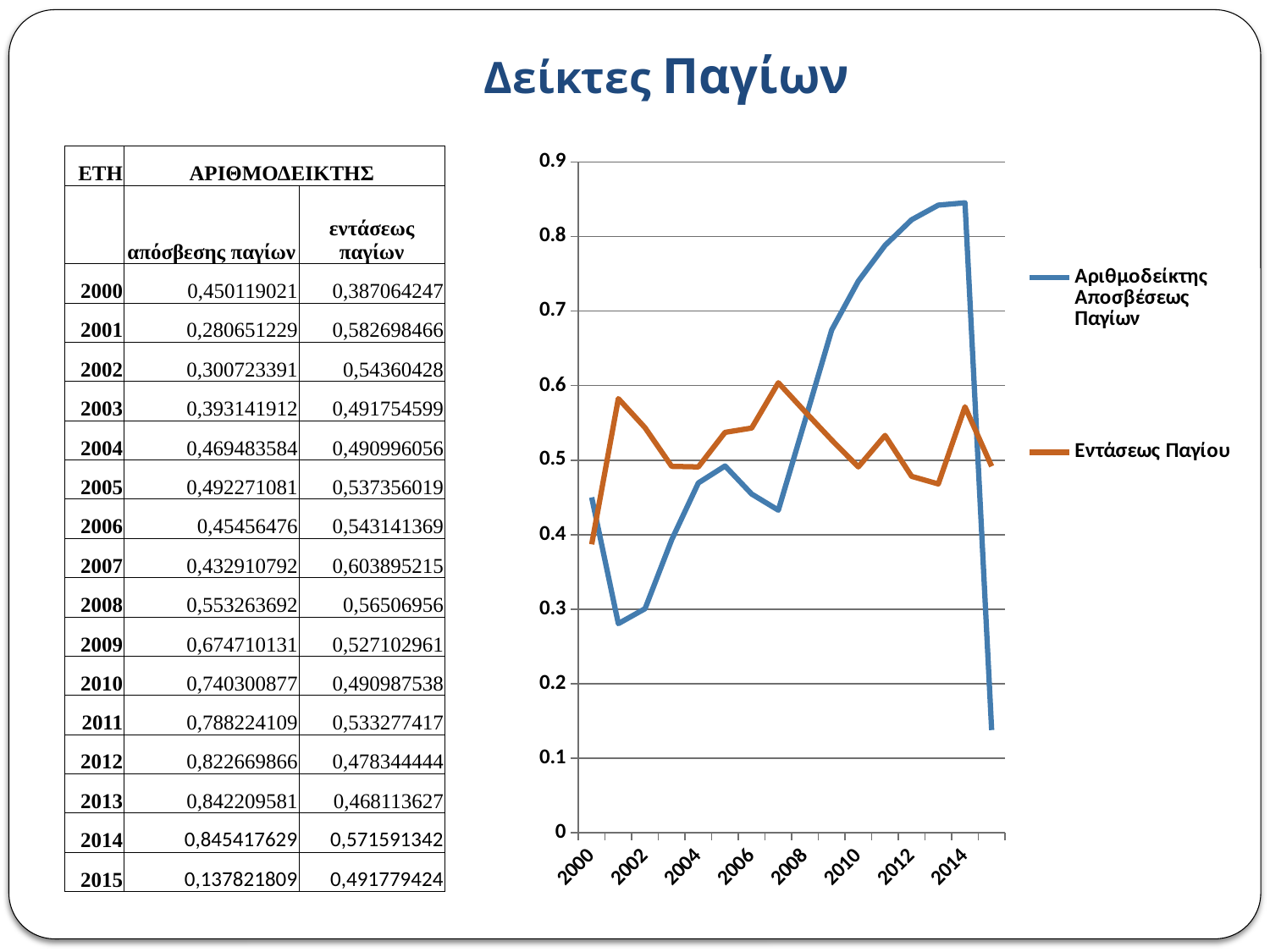
What type of chart is shown on the slide? Line chart In 2005, which series has the larger value: Αριθμοδείκτης Αποσβέσεως Παγίων or Εντάσεως Παγίου? Εντάσεως Παγίου In which year does the Αριθμοδείκτης Αποσβέσεως Παγίων series reach its lowest value? 2015 In 2012, which series has the larger value: Αριθμοδείκτης Αποσβέσεως Παγίων or Εντάσεως Παγίου? Αριθμοδείκτης Αποσβέσεως Παγίων What colour is the line for the Εντάσεως Παγίου series? Orange Is the value of Αριθμοδείκτης Αποσβέσεως Παγίων in 2010 greater or less than 0.7? greater Does the Αριθμοδείκτης Αποσβέσεως Παγίων series rise or fall from 2009 to 2014? Rise How many series does the chart legend list? 2 How many years (data points) are plotted for each series in the chart? 16 In which year does the Εντάσεως Παγίου series reach its highest value? 2007 Is the value of Αριθμοδείκτης Αποσβέσεως Παγίων in 2001 greater or less than 0.3? less In which year is the Εντάσεως Παγίου series at its lowest value? 2000